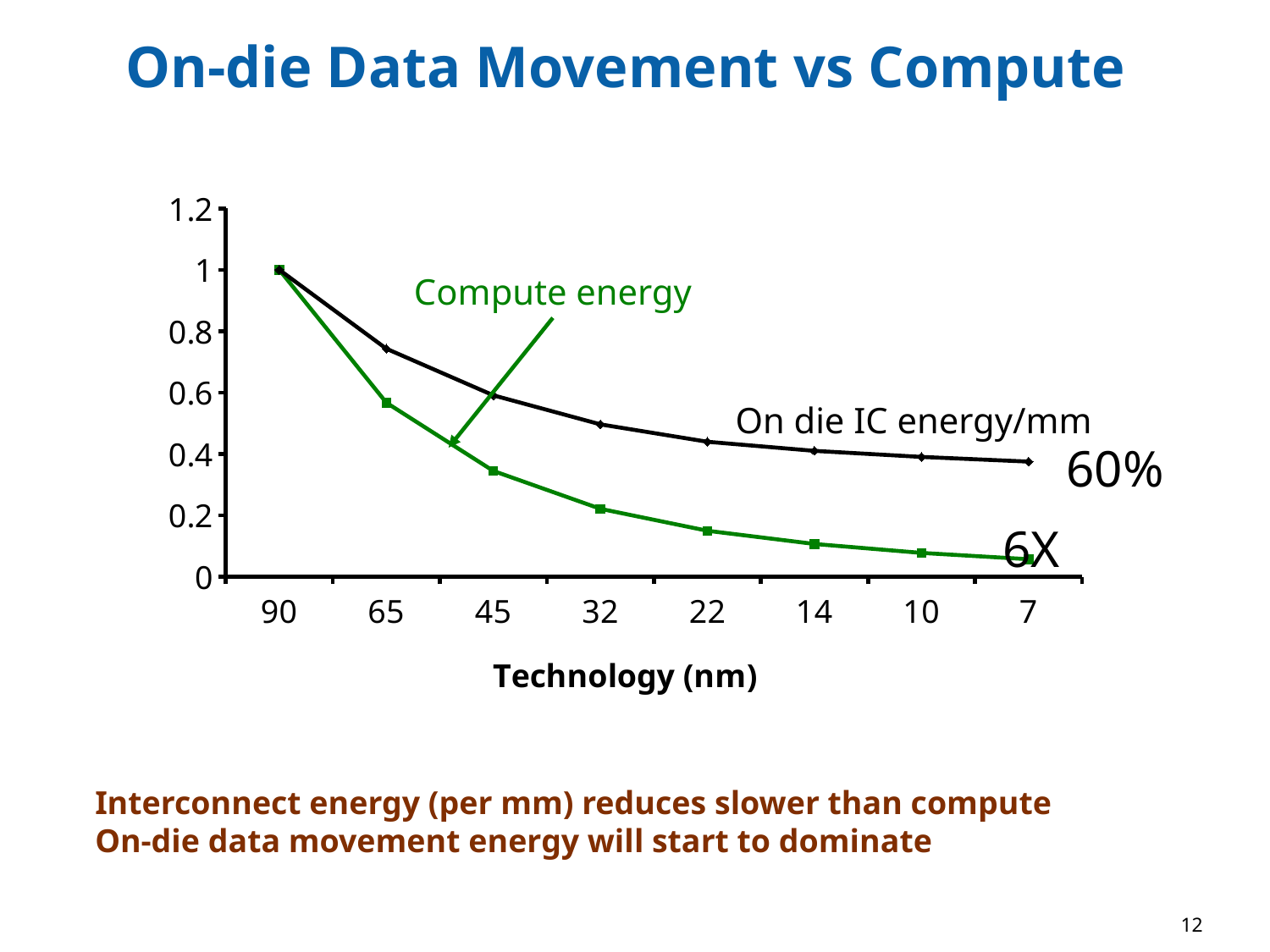
How many data series are plotted on the chart? 2 Is the value for Compute energy at 65 nm greater or less than 0.4? greater How many technology nodes are shown on the x axis? 8 What is the value of Compute energy at 90 nm? 1 What kind of chart is shown on the slide? line chart What is the label of the x axis? Technology (nm) Is the value for Compute energy at 7 nm greater or less than 0.2? less Do the values of Compute energy rise or fall as the technology node moves from 90 nm to 7 nm? fall At 45 nm, which series has the higher value, Compute energy or On die IC energy/mm? On die IC energy/mm Is the value for On die IC energy/mm at 32 nm greater or less than 0.4? greater What is the value of On die IC energy/mm at 90 nm? 1